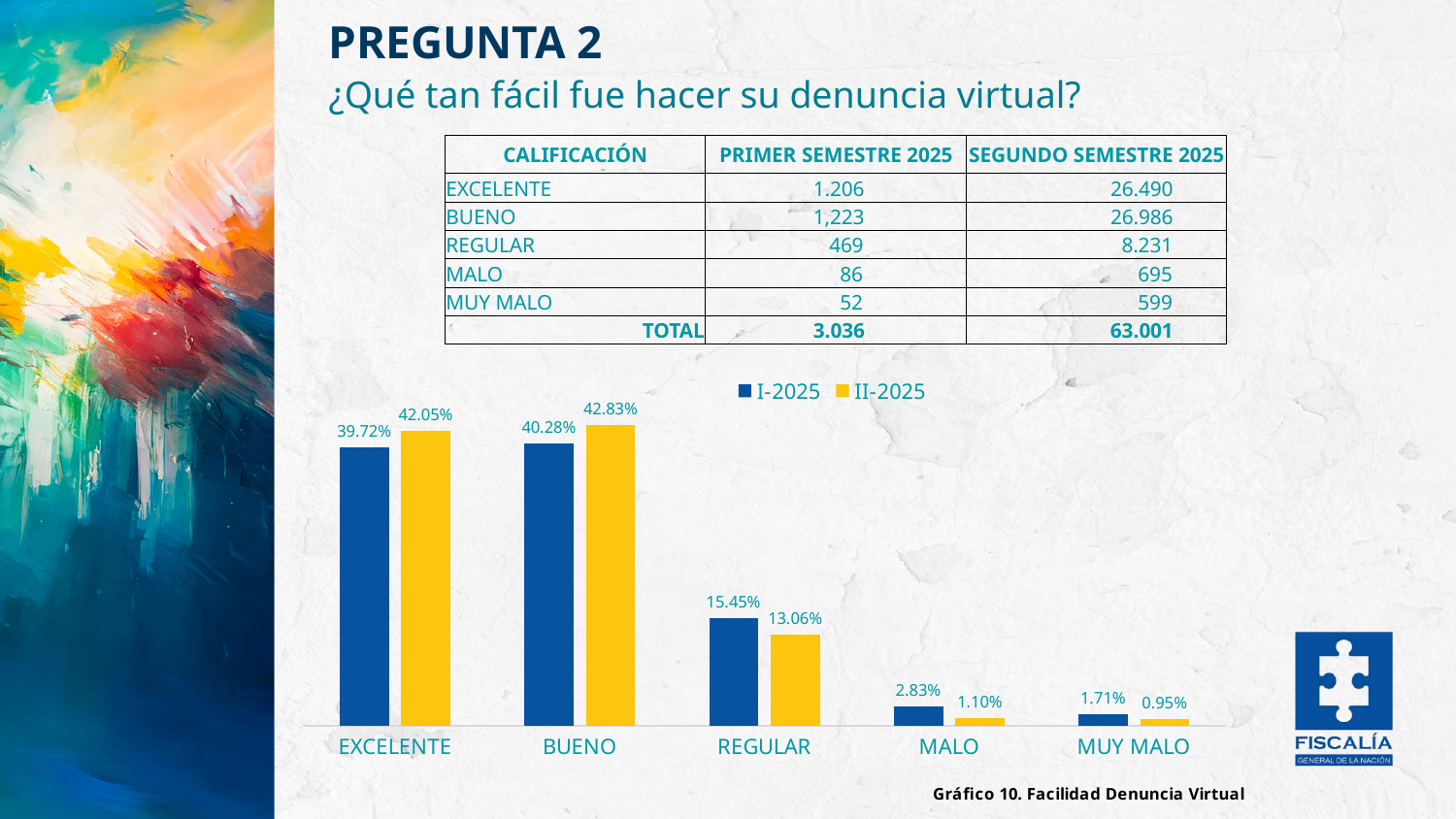
For MALO, which series has the larger value, I-2025 or II-2025? I-2025 What is the value for REGULAR in the II-2025 series? 13.06% What is the value for BUENO in the II-2025 series? 42.83% What type of chart is shown on the slide? bar chart What is the value for MUY MALO in the I-2025 series? 1.71% What is the value for EXCELENTE in the I-2025 series? 39.72% Which category has the highest value in the II-2025 series? BUENO Which category has the lowest value in the I-2025 series? MUY MALO How many categories are shown on the x axis of the chart? 5 How many series does the chart legend list? 2 What are the two series names listed in the chart legend? I-2025 and II-2025 What is the difference between the I-2025 and II-2025 values for REGULAR? 2.39%